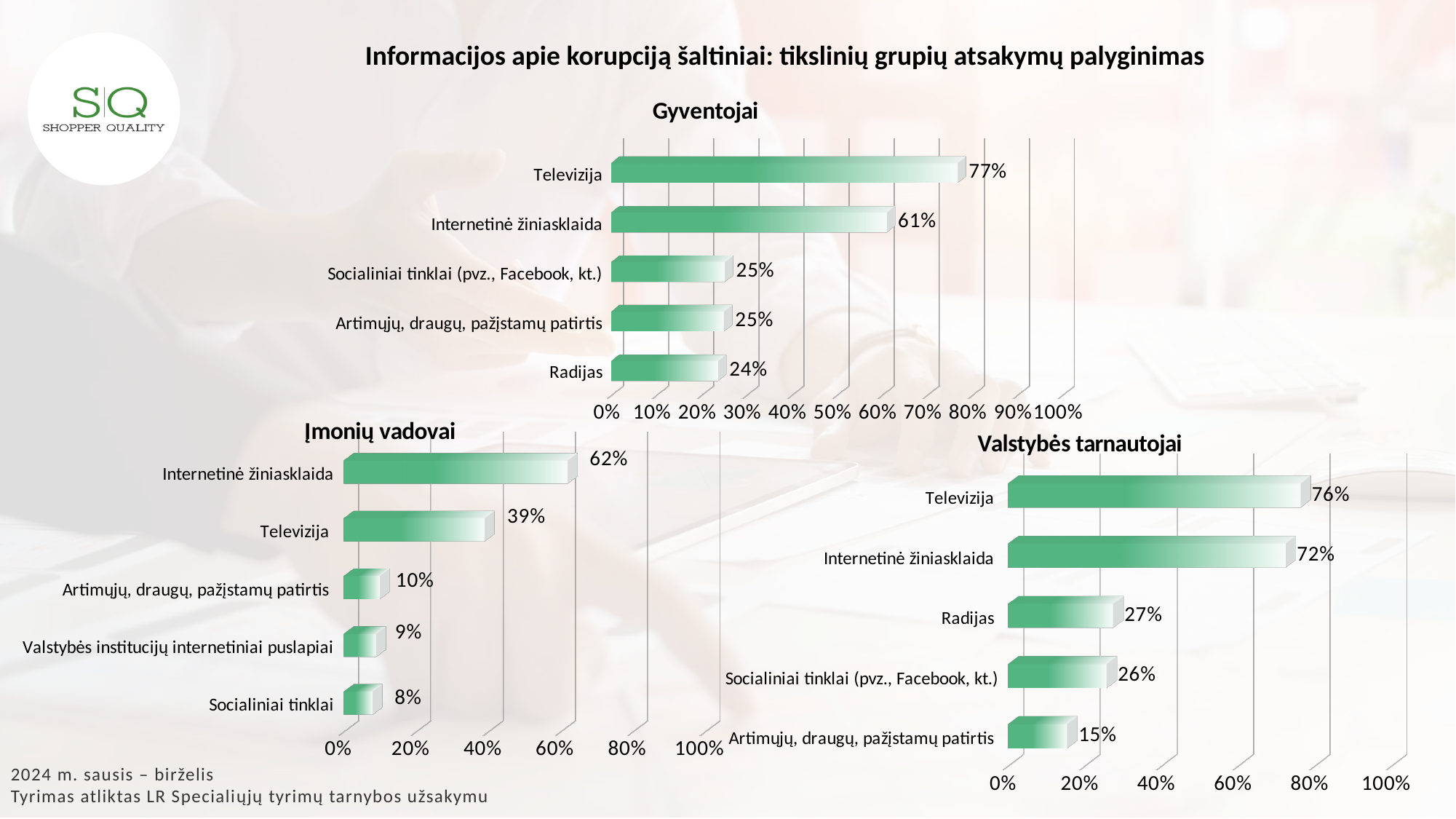
In the "Gyventojai" chart, which category has the lowest value? Radijas In the "Įmonių vadovai" chart, which category has the highest value? Internetinė žiniasklaida How many charts are shown on the slide? 3 How many categories are shown in the "Įmonių vadovai" chart? 5 In the "Valstybės tarnautojai" chart, which is larger: Televizija or Internetinė žiniasklaida? Televizija In the "Valstybės tarnautojai" chart, what is the difference between Televizija and Artimųjų, draugų, pažįstamų patirtis? 61% What type of chart is the "Gyventojai" chart? Bar chart In the "Įmonių vadovai" chart, what is the value for Valstybės institucijų internetiniai puslapiai? 9% In the "Įmonių vadovai" chart, what is the value for Internetinė žiniasklaida? 62% In the "Gyventojai" chart, what is the difference between Televizija and Internetinė žiniasklaida? 16% In the "Valstybės tarnautojai" chart, what is the value for Radijas? 27% In the "Gyventojai" chart, what is the value for Televizija? 77%